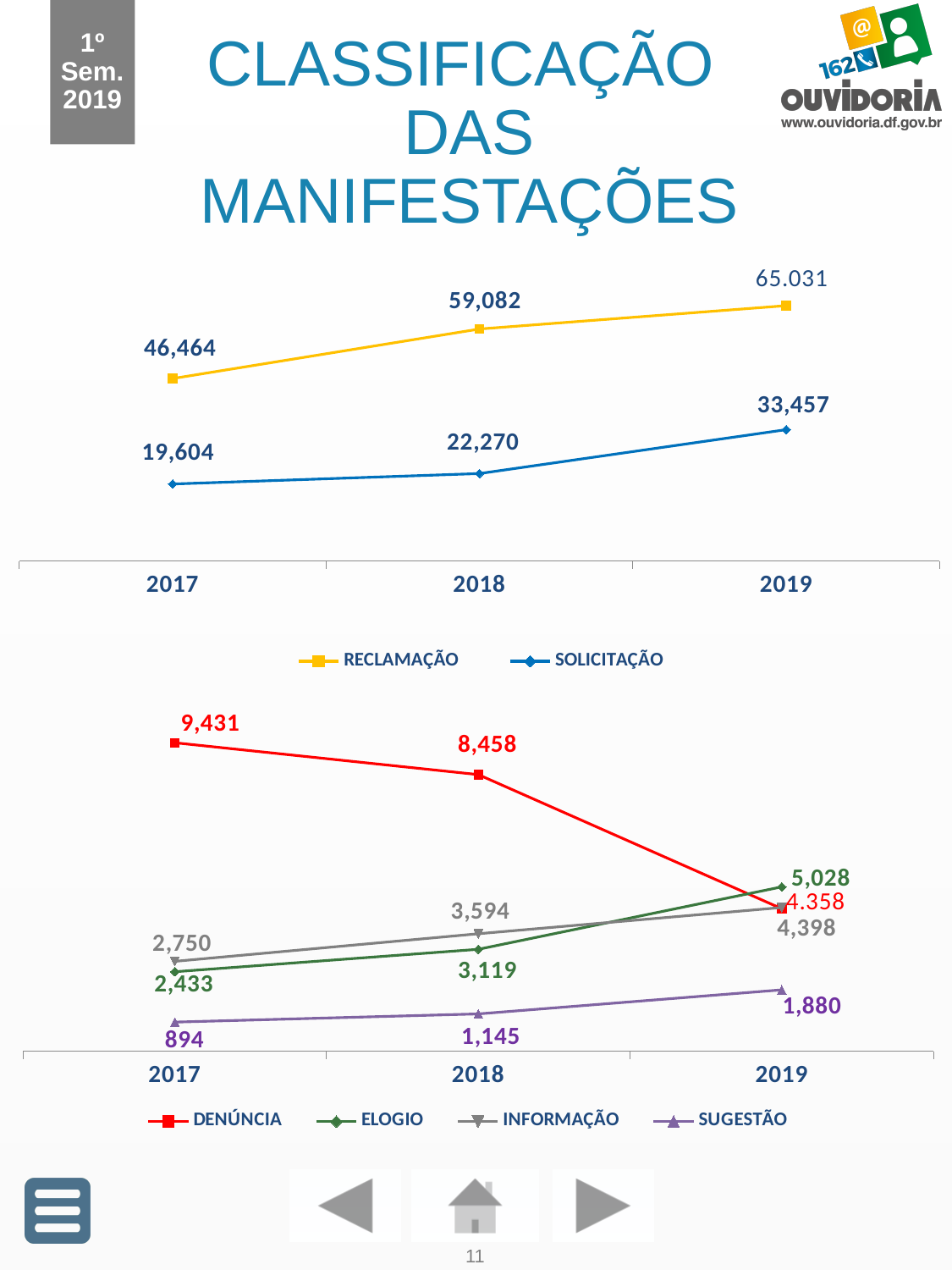
In the bottom chart, what is the value for SUGESTÃO in 2018? 1,145 How many series does the legend of the top chart list? 2 In the bottom chart, does the DENÚNCIA series rise or fall from 2017 to 2019? fall In the top chart, what is the value for RECLAMAÇÃO in 2018? 59,082 In the top chart, what is the difference between RECLAMAÇÃO and SOLICITAÇÃO in 2017? 26,860 In the bottom chart, what is the value for DENÚNCIA in 2017? 9,431 In the bottom chart, which series has the lowest value in 2017? SUGESTÃO What kind of chart is the bottom chart? line chart In the top chart, what is the value for RECLAMAÇÃO in 2019? 65.031 In the top chart, what is the value for SOLICITAÇÃO in 2019? 33,457 In the top chart, does the SOLICITAÇÃO series rise or fall from 2017 to 2019? rise In the bottom chart, which series has the highest value in 2019? ELOGIO